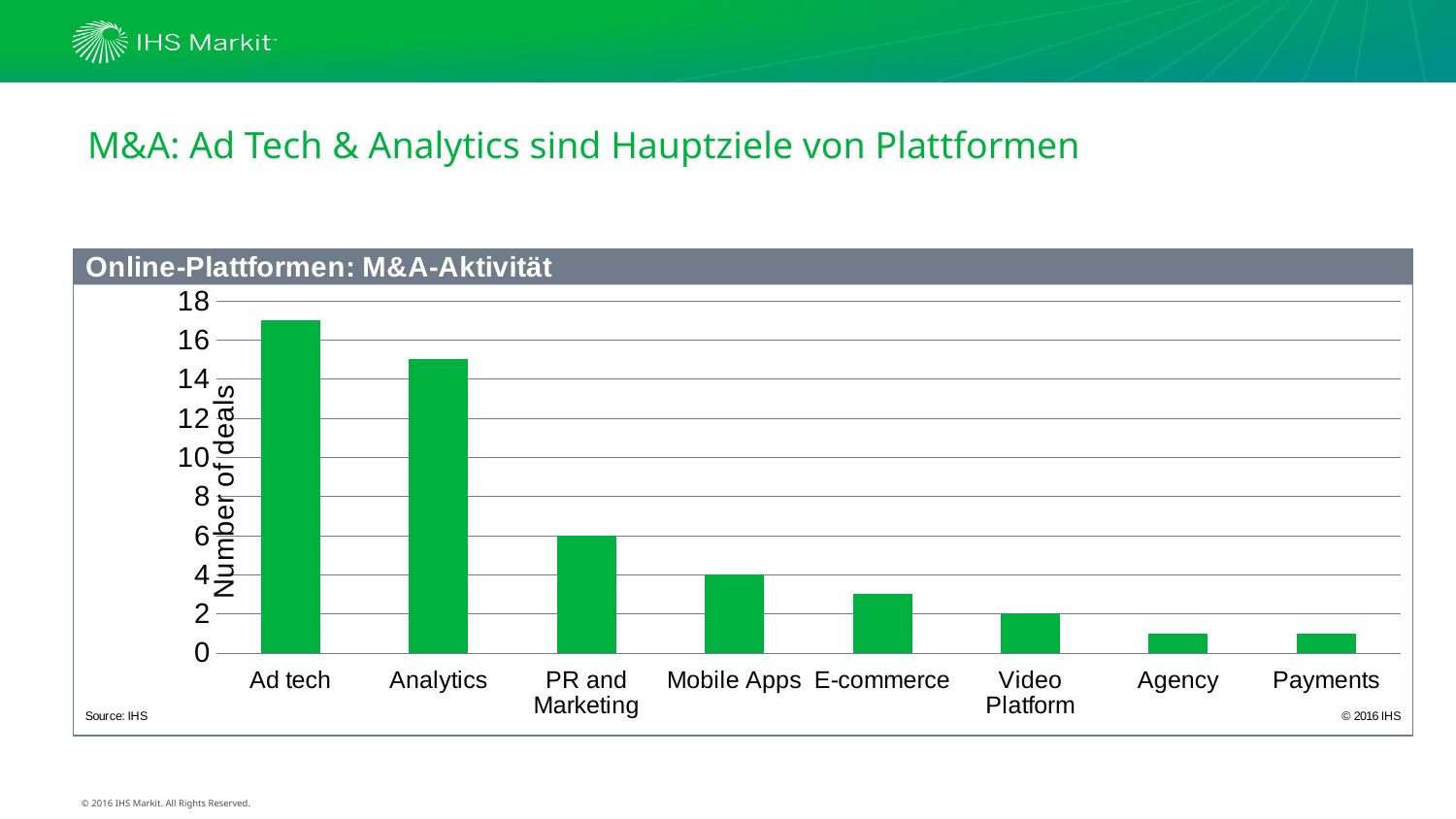
What is the number of deals for PR and Marketing? 6 What kind of chart is shown on the slide? Bar chart How many categories are shown on the x axis? 8 What is the number of deals for Mobile Apps? 4 What is the number of deals for Video Platform? 2 Which has more deals, Ad tech or Analytics? Ad tech What is the title of the chart? Online-Plattformen: M&A-Aktivität Which category has the highest number of deals? Ad tech Is the value for Ad tech greater or less than 16? greater What is the difference in number of deals between PR and Marketing and Mobile Apps? 2 What is the label of the vertical axis? Number of deals Do the values rise or fall from left to right along the x axis? Fall